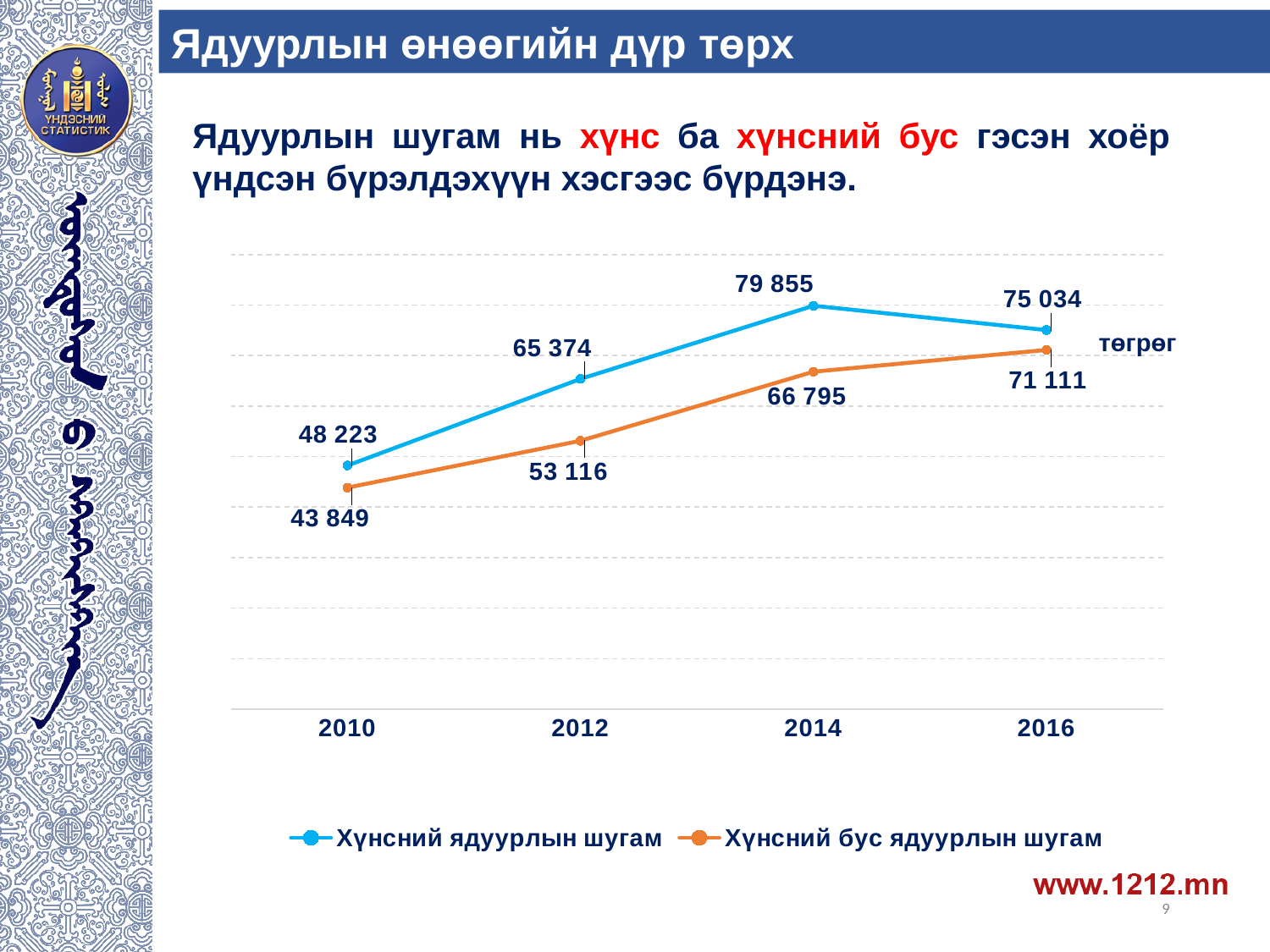
What is the value of Хүнсний бус ядуурлын шугам in 2010? 43 849 What kind of chart is shown on the slide? Line chart What is the difference between Хүнсний ядуурлын шугам and Хүнсний бус ядуурлын шугам in 2014? 13 060 In which year is Хүнсний бус ядуурлын шугам lowest? 2010 What is the value of Хүнсний ядуурлын шугам in 2014? 79 855 In which year is Хүнсний ядуурлын шугам highest? 2014 How many years are shown on the x axis? 4 What is the value of Хүнсний бус ядуурлын шугам in 2012? 53 116 How many series does the legend list? 2 What is the value of Хүнсний ядуурлын шугам in 2016? 75 034 Does Хүнсний бус ядуурлын шугам rise or fall from 2010 to 2016? Rise Which is larger in 2016: Хүнсний ядуурлын шугам or Хүнсний бус ядуурлын шугам? Хүнсний ядуурлын шугам